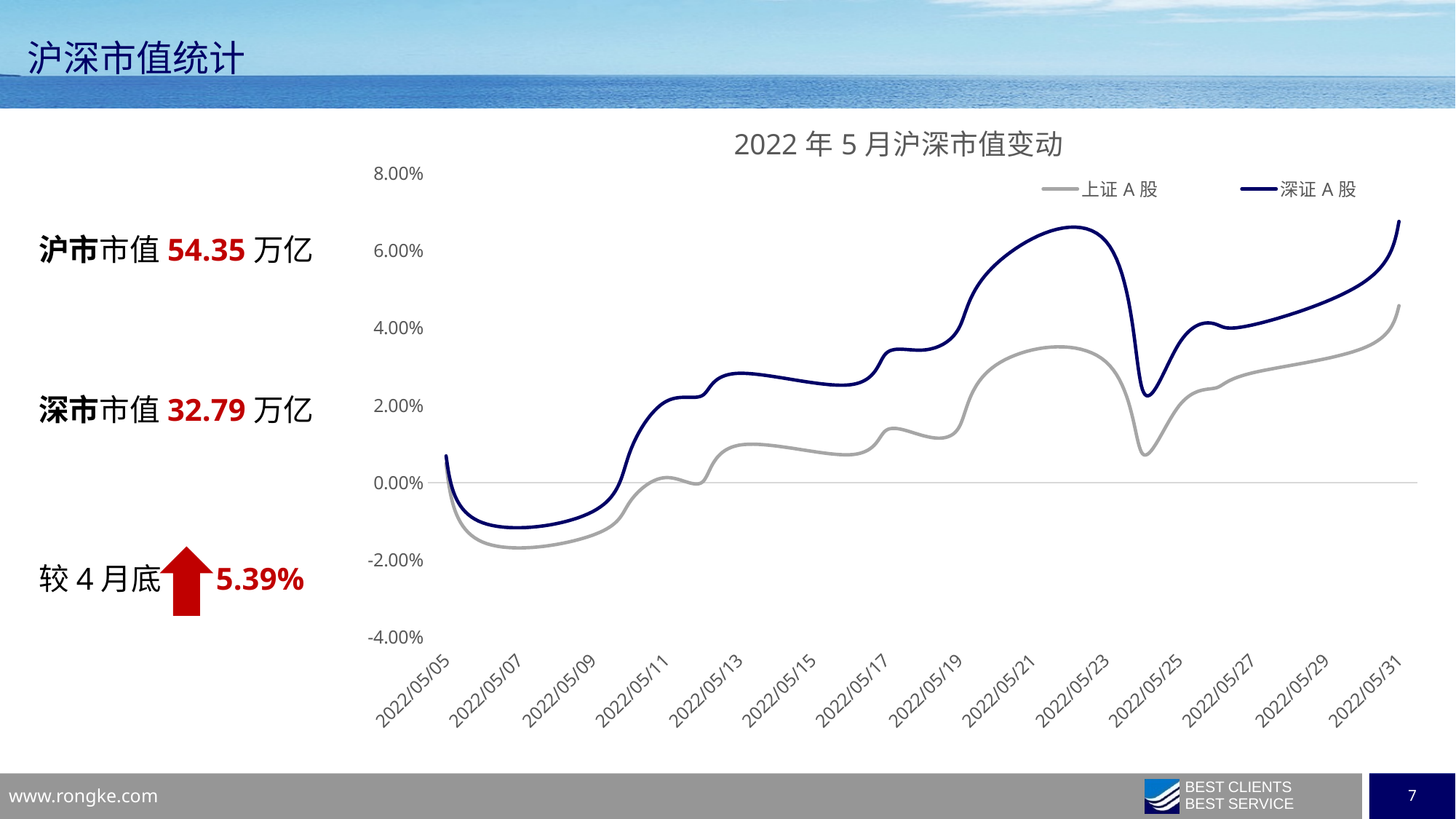
Overall, do the values for 深证A股 rise or fall from 2022/05/05 to 2022/05/31? Rise What is the title of the chart? 2022年5月沪深市值变动 How many date labels are shown on the x axis? 14 How many series does the chart legend list? 2 At 2022/05/31, which series has the higher value, 上证A股 or 深证A股? 深证A股 Which series reaches the highest value on the chart? 深证A股 Is the value for 上证A股 at 2022/05/31 greater or less than 4.00%? greater What kind of chart is shown on the slide? Line chart Is the value for 深证A股 at 2022/05/31 greater or less than 6.00%? greater Which colour is used for the 深证A股 line? Dark blue